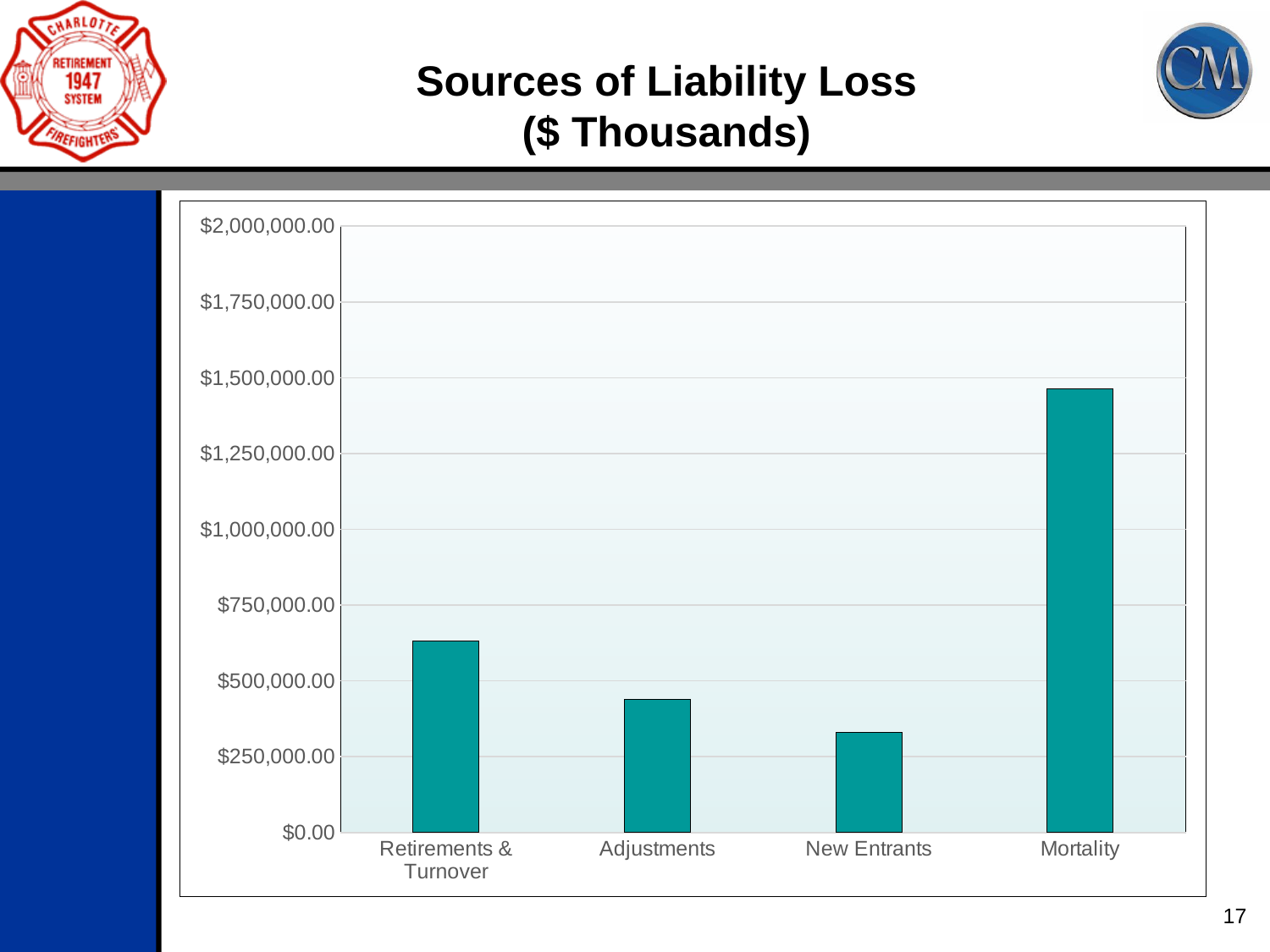
Which is larger, the value for Adjustments or the value for New Entrants? Adjustments Is the value for Retirements & Turnover greater or less than $500,000.00? greater What kind of chart is shown on the slide? bar chart Is the value for Mortality greater or less than $1,250,000.00? greater Is the value for New Entrants greater or less than $250,000.00? greater Which category has the highest value? Mortality How many categories are shown on the x axis? 4 Which is larger, the value for Retirements & Turnover or the value for Adjustments? Retirements & Turnover Which category has the lowest value? New Entrants What is the title of the chart? Sources of Liability Loss ($ Thousands)